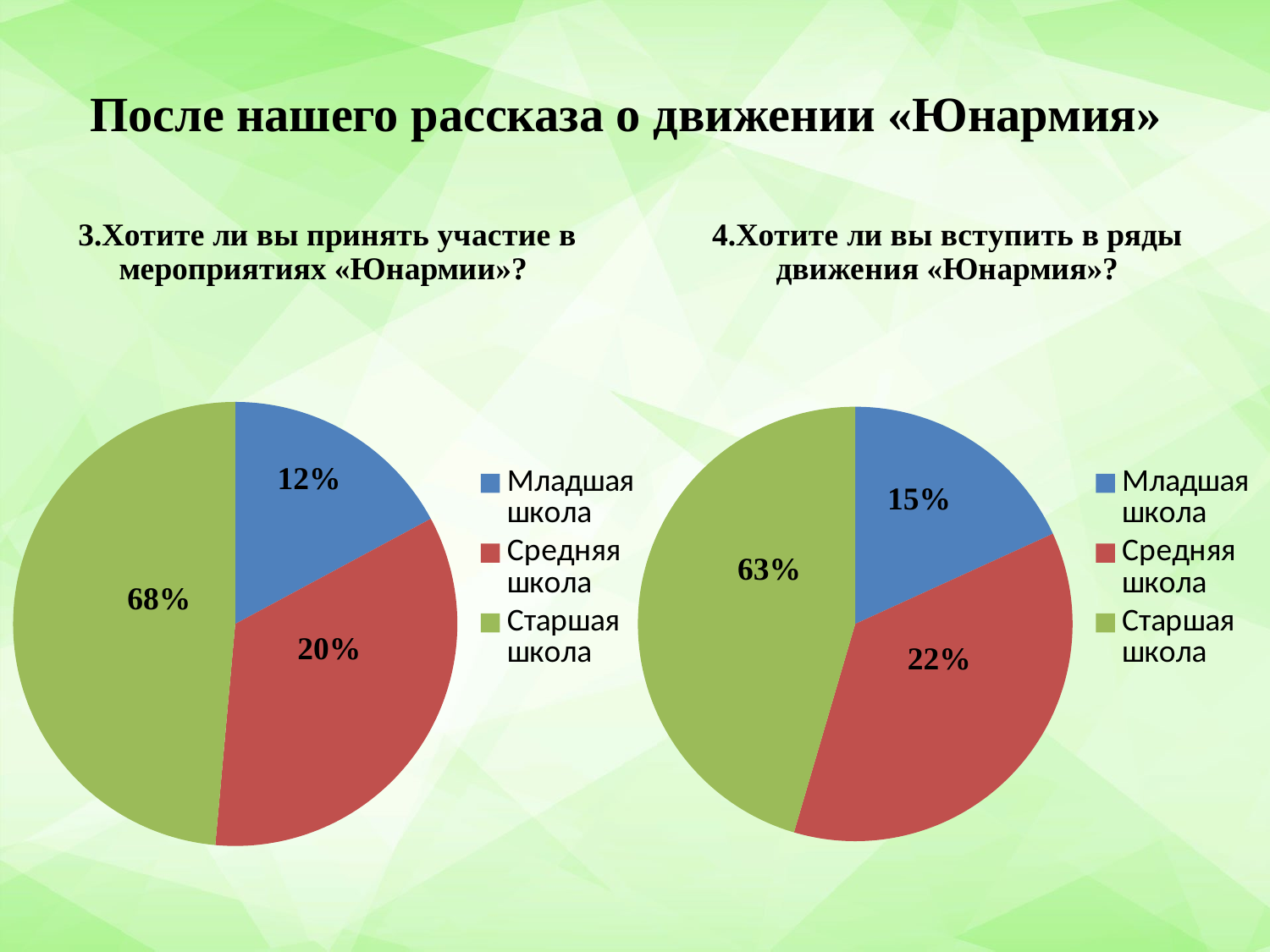
In the right pie chart (question 4), which category has the smallest slice? Младшая школа In the right pie chart (question 4), what share is labelled for Средняя школа? 22% In the right pie chart (question 4), which is larger: the share for Младшая школа or the share for Средняя школа? Средняя школа How many slices does the left pie chart (question 3) have? 3 How many entries does the legend of the left chart (question 3) list? 3 In the left pie chart (question 3), which category has the largest slice? Старшая школа In the left pie chart (question 3), what share is labelled for Старшая школа? 68% In the left pie chart (question 3), what share is labelled for Младшая школа? 12% What kind of chart is used for question 4 on the right? Pie chart In the right pie chart (question 4), what share is labelled for Старшая школа? 63% In the left pie chart (question 3), what is the difference between the shares for Старшая школа and Средняя школа? 48% In the right pie chart (question 4), what is the difference between the shares for Средняя школа and Младшая школа? 7%